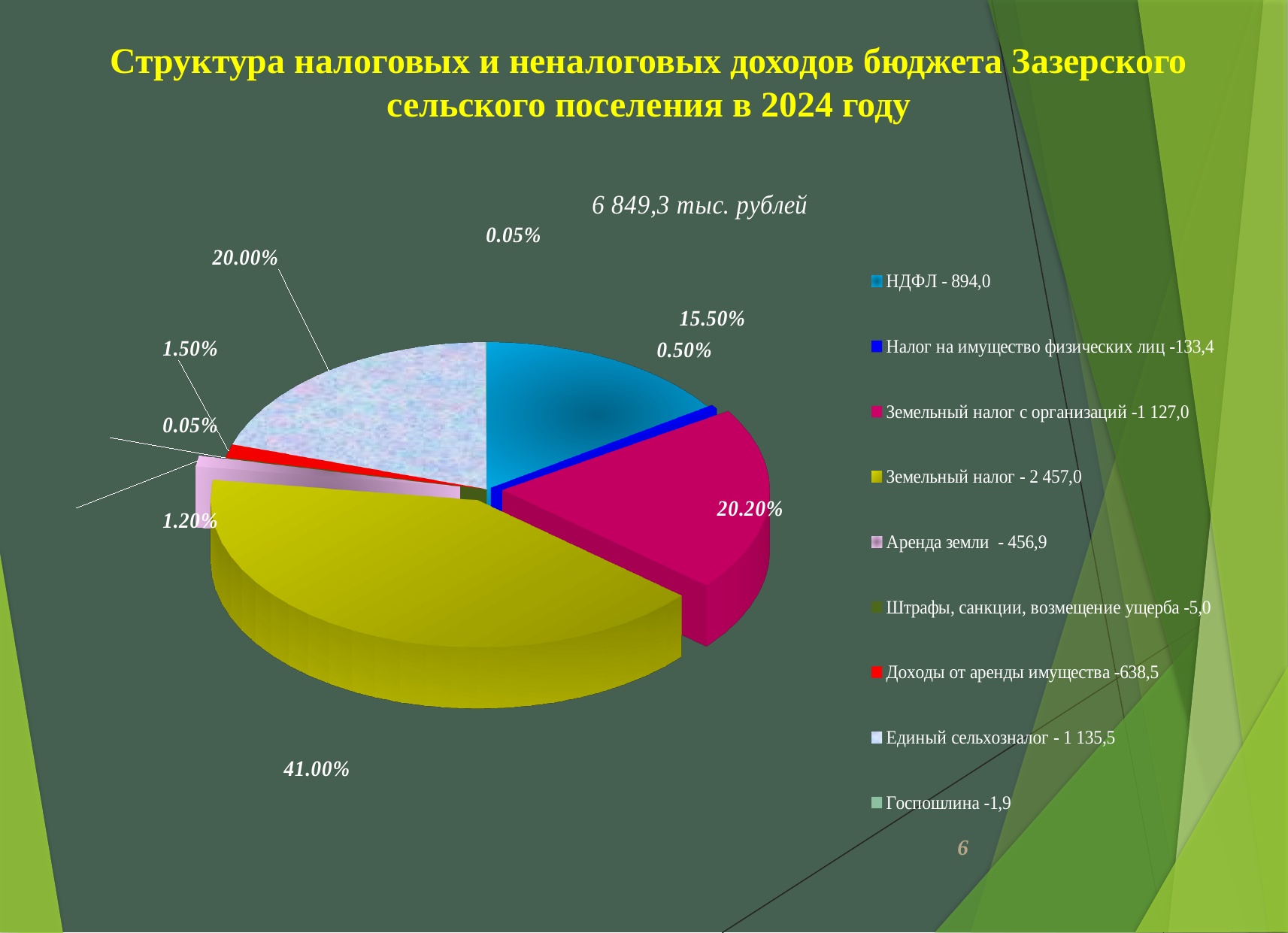
What is the difference between the legend values for Единый сельхозналог and Земельный налог с организаций? 8,5 What value is given for Госпошлина in the legend? 1,9 What value is given for Земельный налог с организаций in the legend? 1 127,0 What value is given for НДФЛ in the legend? 894,0 Which category has the largest slice of the pie chart? Земельный налог What value is given for Единый сельхозналог in the legend? 1 135,5 What percentage label is shown for the largest slice of the pie chart? 41.00% Which category has the smallest value in the legend? Госпошлина How many entries does the legend of the pie chart list? 9 What kind of chart is shown on the slide? pie chart What total amount is shown above the pie chart? 6 849,3 тыс. рублей Which is larger according to the legend: Земельный налог or Земельный налог с организаций? Земельный налог